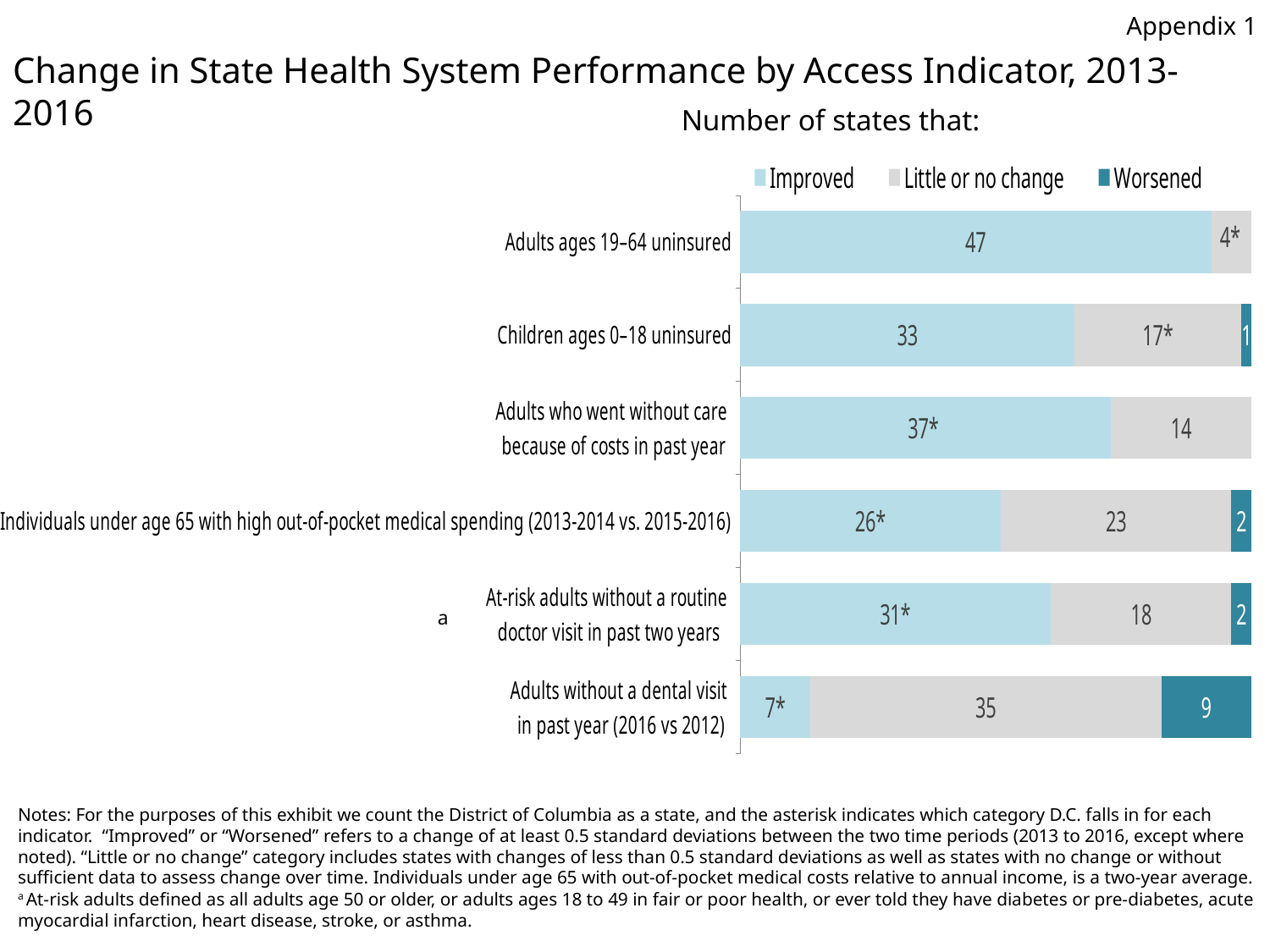
What is the 'Little or no change' value for 'Adults who went without care because of costs in past year'? 14 How many states improved on the 'Adults ages 19–64 uninsured' indicator? 47 How many states worsened on the 'Adults without a dental visit in past year (2016 vs 2012)' indicator? 9 Which indicator has the lowest number of states that improved? Adults without a dental visit in past year (2016 vs 2012) How many series does the legend list? 3 Which indicator has the highest number of states that improved? Adults ages 19–64 uninsured What is the 'Improved' value shown for 'At-risk adults without a routine doctor visit in past two years'? 31* What is the difference between the 'Improved' values for 'Children ages 0–18 uninsured' and 'Adults ages 19–64 uninsured'? 14 Which has more states in the 'Little or no change' category: 'Adults without a dental visit in past year (2016 vs 2012)' or 'Individuals under age 65 with high out-of-pocket medical spending (2013-2014 vs. 2015-2016)'? Adults without a dental visit in past year (2016 vs 2012) What is the total number of states across all three categories for 'Children ages 0–18 uninsured'? 51 What type of chart is shown on the slide? Stacked bar chart How many access indicators (categories) are shown in the chart? 6